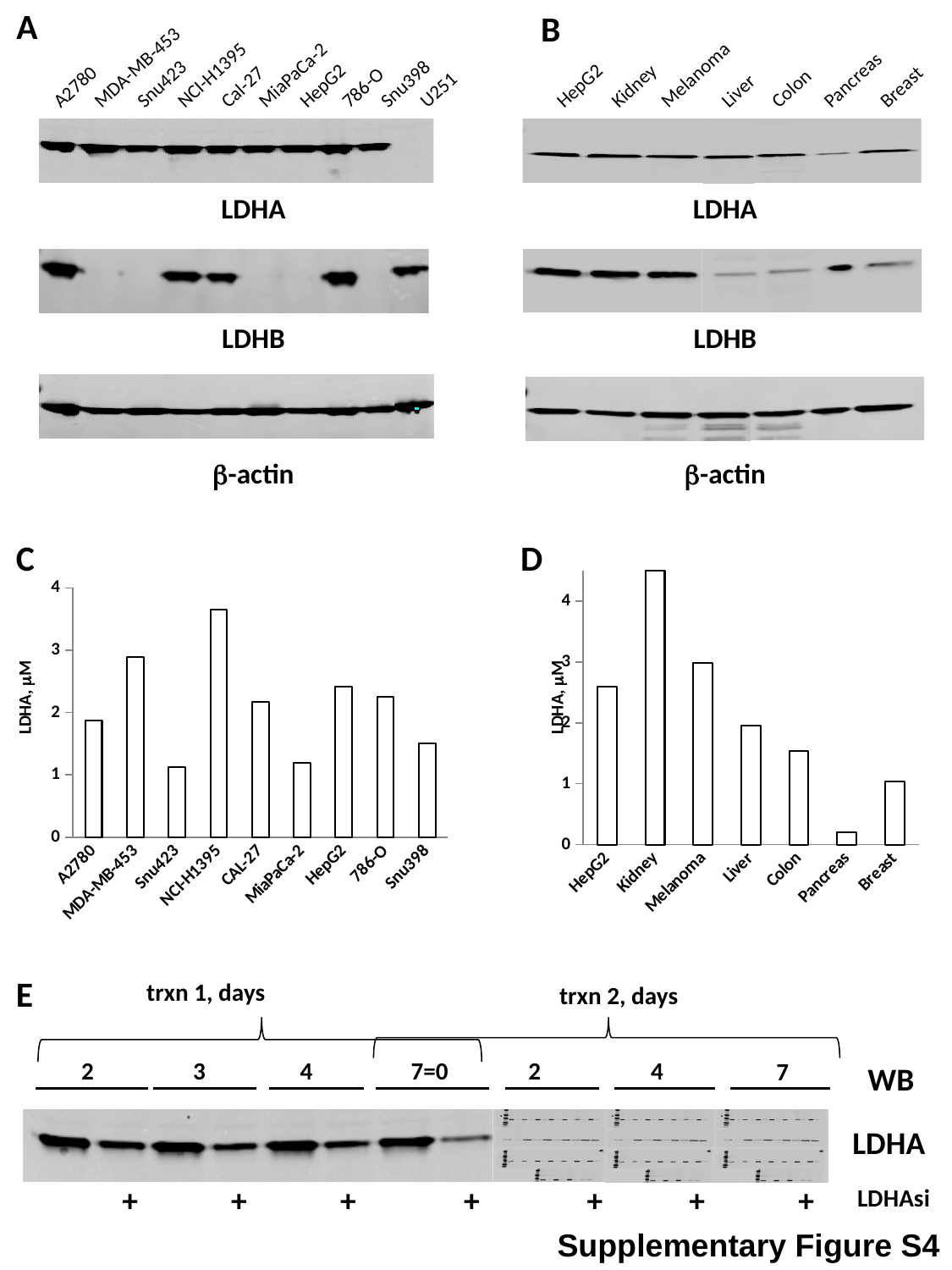
In chart C, which cell line has the highest LDHA value? NCI-H1395 What kind of chart is chart C? bar chart In chart C, is the value for MDA-MB-453 greater or less than 2? greater How many categories are plotted in chart D? 7 In chart C, is the value for Snu423 greater or less than 2? less In chart D, which has the larger LDHA value, Melanoma or Liver? Melanoma How many cell lines are plotted in chart C? 9 In chart D, which category has the highest LDHA value? Kidney What is the y-axis label of chart C? LDHA, µM In chart C, which has the larger LDHA value, HepG2 or Snu423? HepG2 In chart D, which category has the lowest LDHA value? Pancreas In chart D, is the value for Kidney greater or less than 4? greater